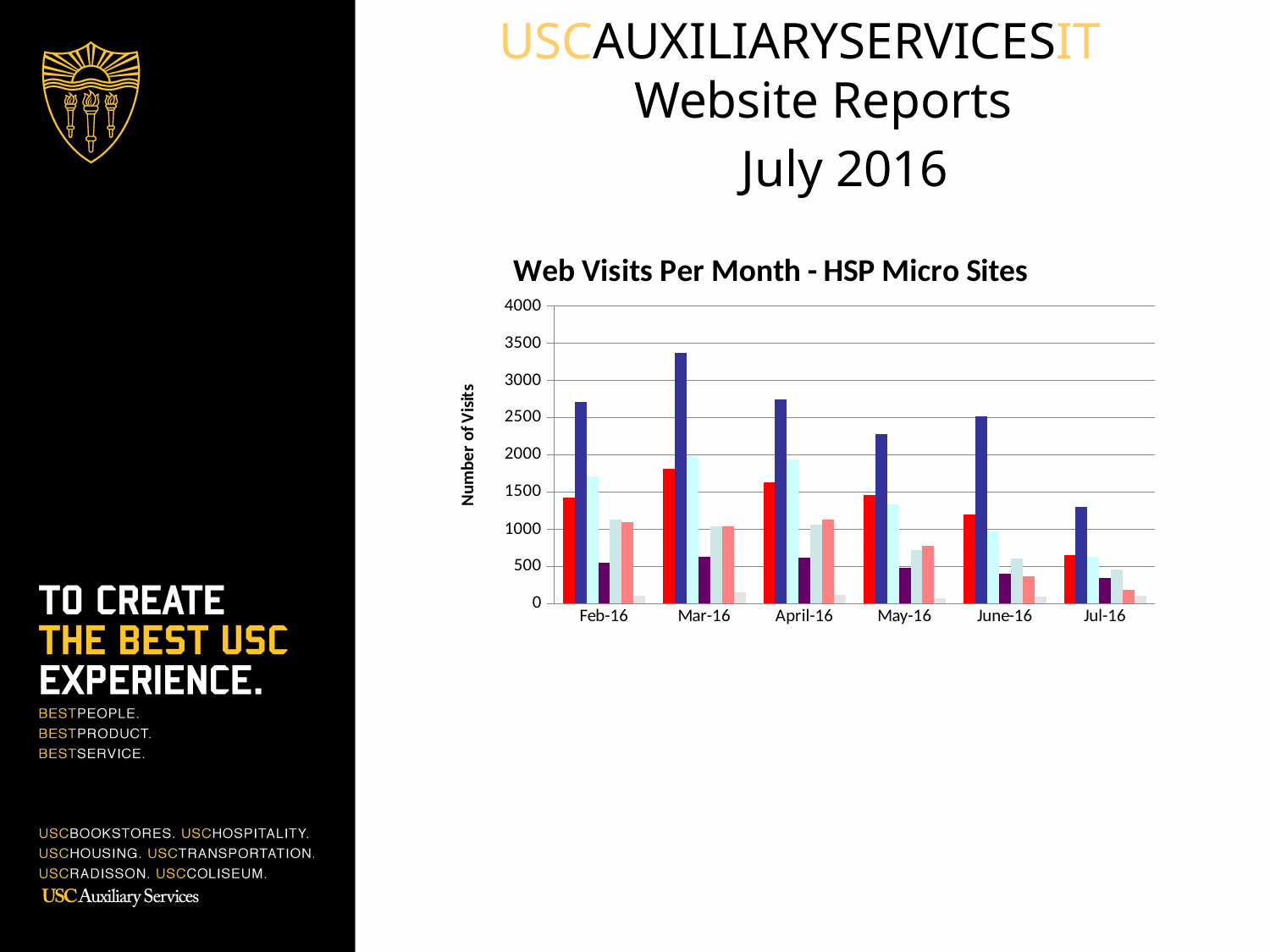
What kind of chart is shown on the slide? bar chart In which month is the dark blue bar the tallest? Mar-16 In which month is the dark blue bar the shortest? Jul-16 Which is larger, the red bar for Feb-16 or the red bar for Mar-16? Mar-16 What is the label on the vertical axis of the chart? Number of Visits Is the value of the dark blue bar for Jul-16 greater or less than 1500? less Is the value of the red bar for Mar-16 greater or less than 1500? greater Is the value of the red bar for Jul-16 greater or less than 1000? less What is the title of the chart? Web Visits Per Month - HSP Micro Sites How many months are shown on the x axis of the chart? 6 From April-16 to Jul-16, does the dark blue bar rise or fall? fall